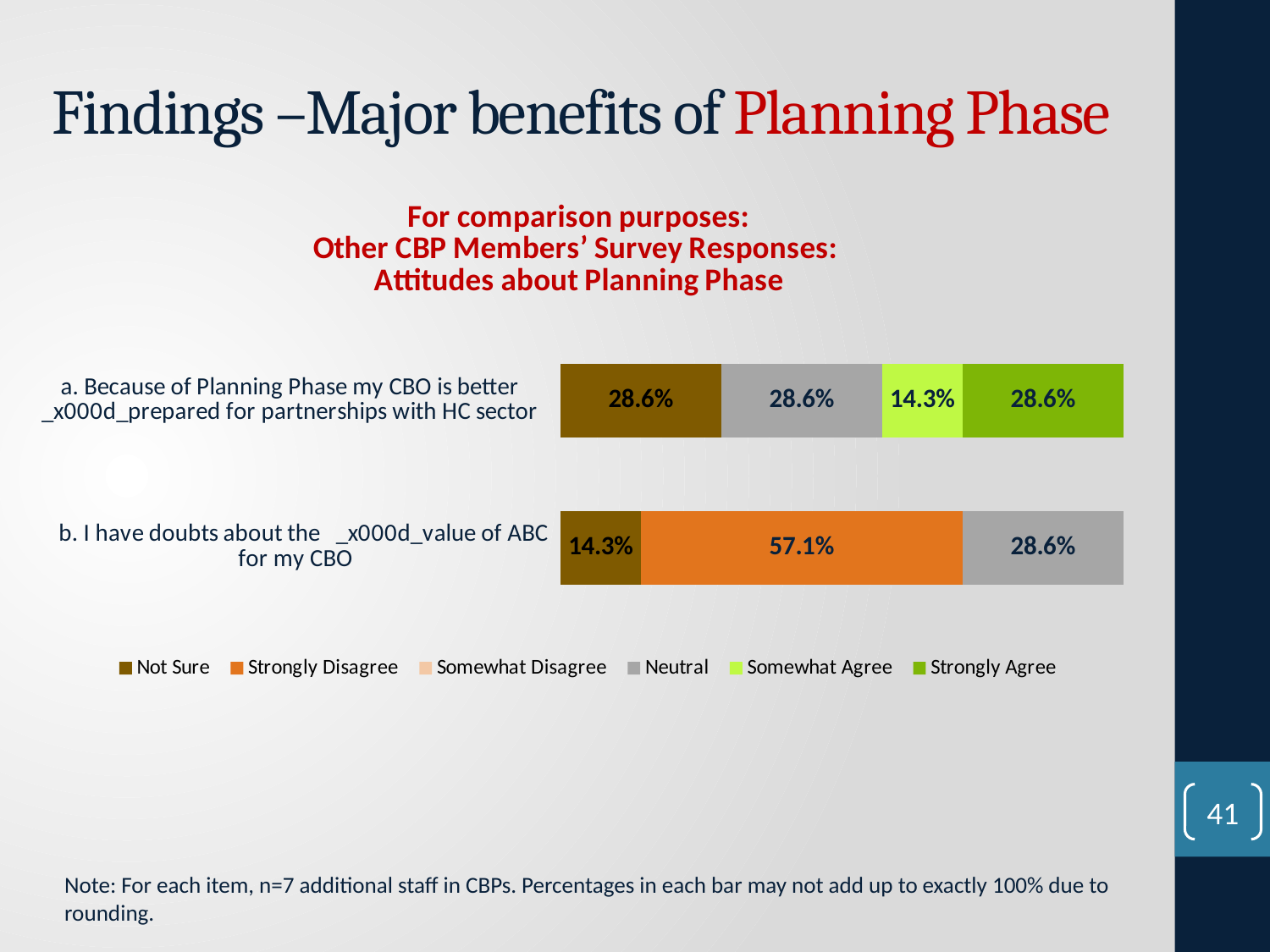
What is the Strongly Agree value for item a? 28.6% What is the Strongly Disagree value for item b ("I have doubts about the value of ABC for my CBO")? 57.1% What is the difference between the Strongly Disagree value and the Not Sure value for item b? 42.8% What is the Neutral value for item b? 28.6% How many survey items (bars) are plotted in the chart? 2 Which is larger for item b: the Not Sure value or the Neutral value? Neutral What type of chart is shown on the slide? stacked bar chart What is the Somewhat Agree value for item a? 14.3% How many series does the chart legend list? 6 Which response category has the smallest share for item a? Somewhat Agree Which response category has the largest share for item b? Strongly Disagree What is the Not Sure value for item a ("Because of Planning Phase my CBO is better prepared for partnerships with HC sector")? 28.6%